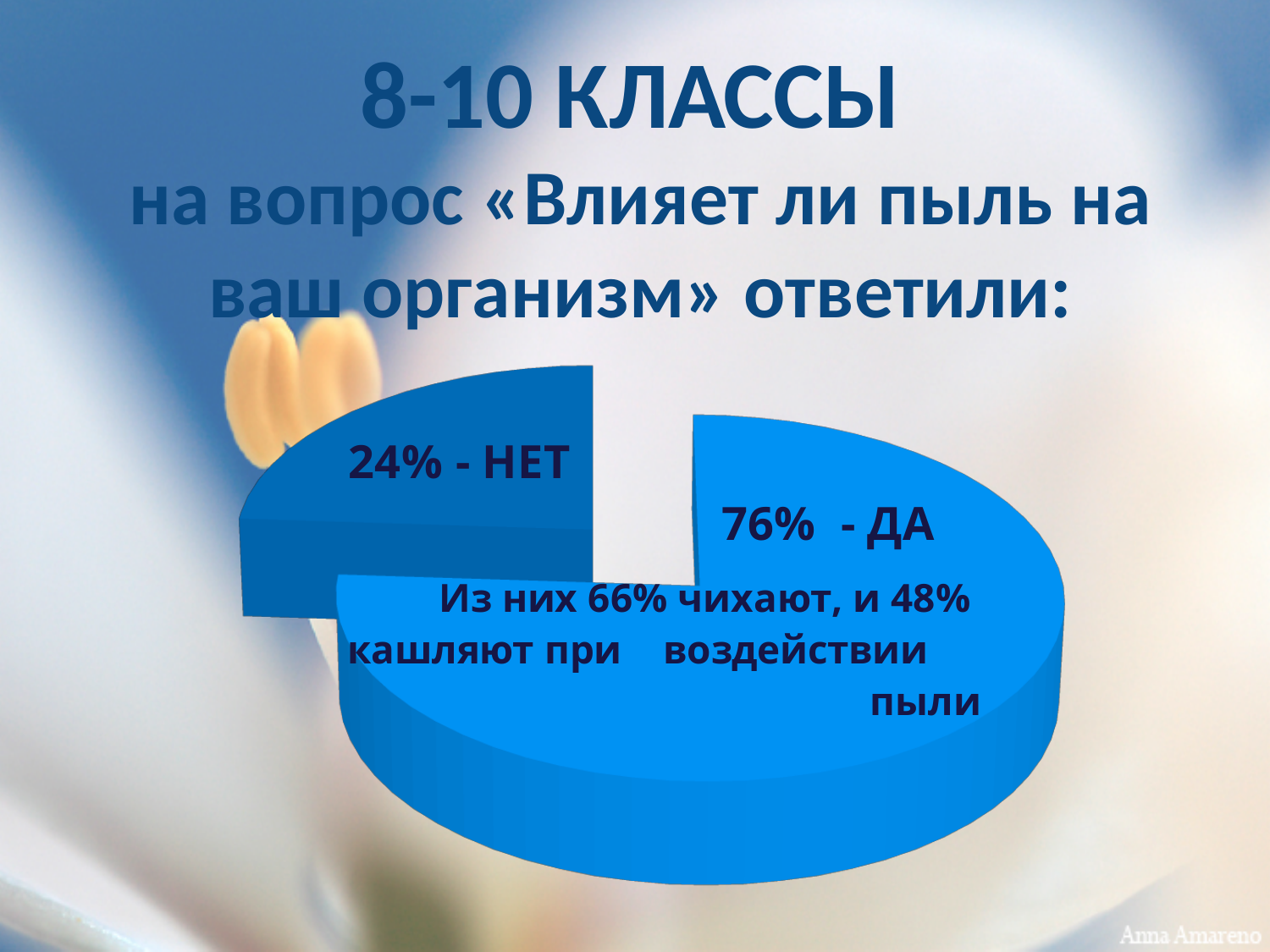
What kind of chart is shown on the slide? pie chart According to the text on the ДА slice, what percentage of those who answered ДА sneeze (чихают) when exposed to dust? 66% Which answer has the largest slice of the pie? ДА What is the difference in percentage points between the ДА slice and the НЕТ slice? 52 Which classes (grades) does the chart title say the survey covers? 8-10 КЛАССЫ What share of the pie is labelled ДА? 76% How many slices does the pie chart have? 2 Which answer has the smallest slice of the pie? НЕТ What share of the pie is labelled НЕТ? 24% According to the text on the ДА slice, what percentage of those who answered ДА cough (кашляют) when exposed to dust? 48% Is the share for НЕТ greater or less than 50%? less Which slice is larger, ДА or НЕТ? ДА